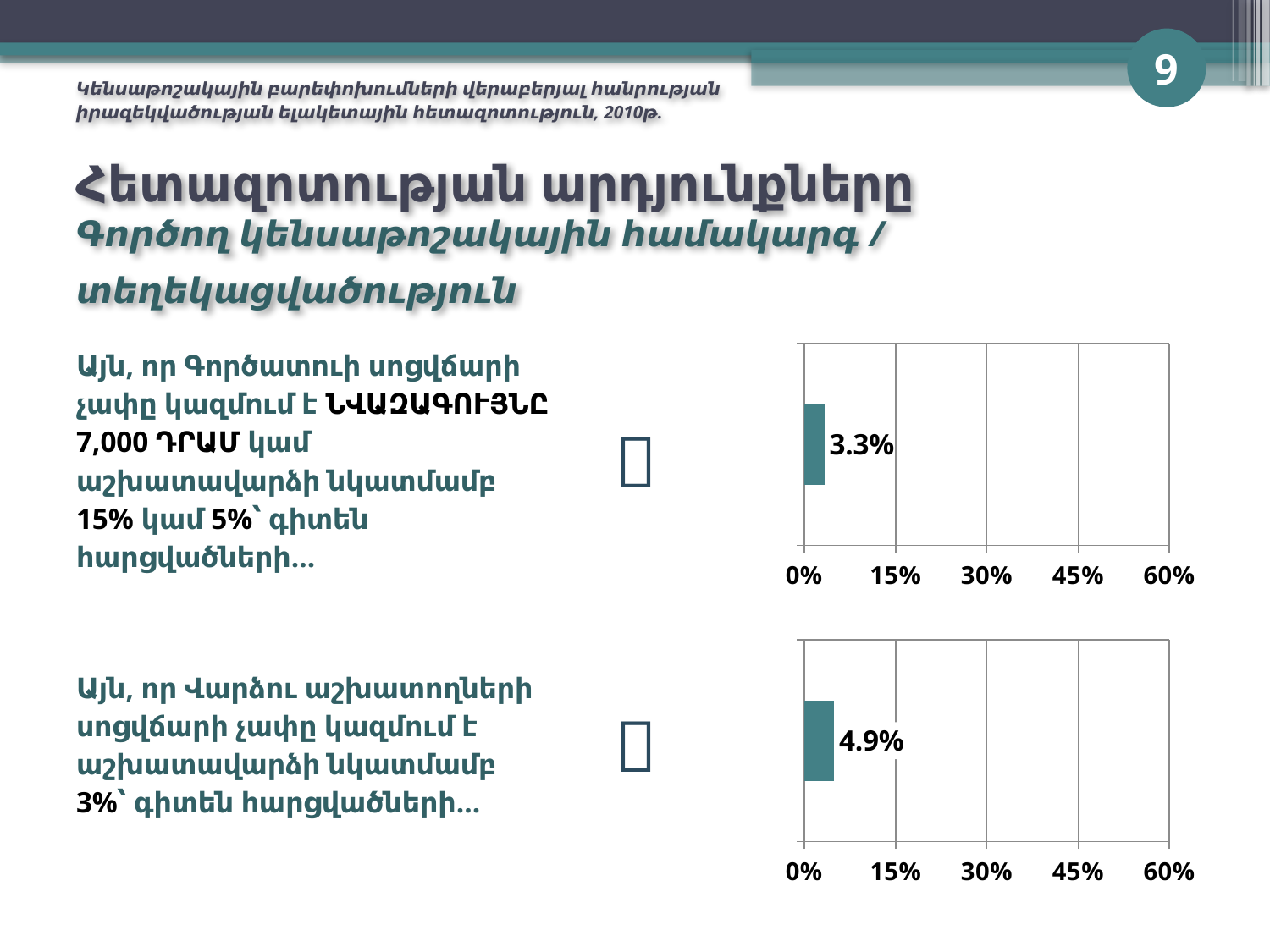
Which chart shows the larger value, the top chart (3.3%) or the bottom chart (4.9%)? the bottom chart What kind of chart is the top chart on the right side of the slide? bar chart In the top chart on the right, what value is shown on the bar? 3.3% What is the difference between the value in the bottom chart (4.9%) and the value in the top chart (3.3%)? 1.6% How many bars are plotted in the top chart on the right? 1 How many bars are plotted in the bottom chart on the right? 1 What kind of chart is the bottom chart on the right side of the slide? bar chart What is the interval between the tick labels on the x axis of the bottom chart? 15% In the bottom chart, is the value of the bar greater or less than 15%? less What is the maximum value shown on the x axis of the top chart? 60% In the top chart, is the value of the bar greater or less than 15%? less In the bottom chart on the right, what value is shown on the bar? 4.9%